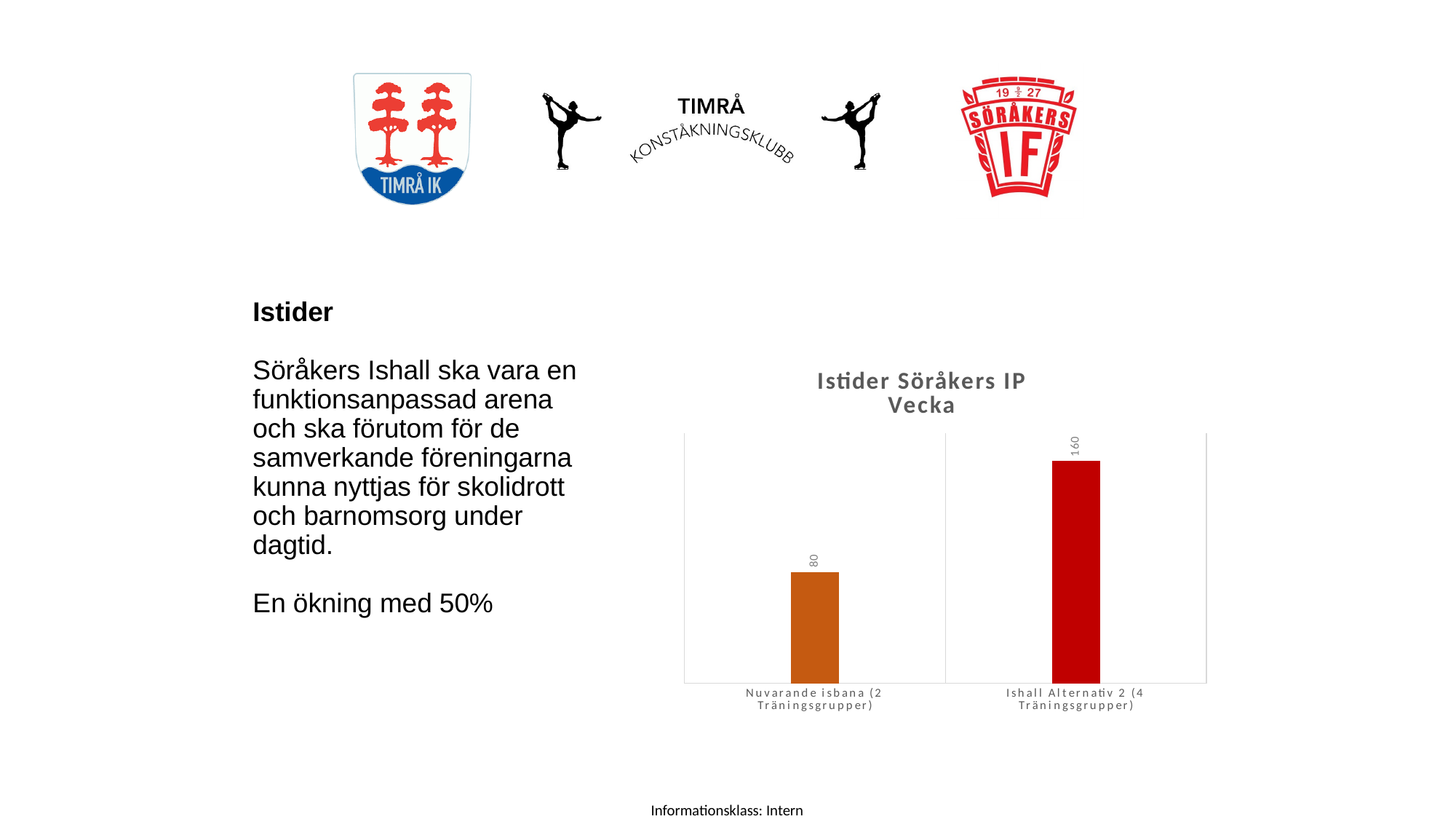
What is the title of the chart? Istider Söråkers IP Vecka Which category has the highest value? Ishall Alternativ 2 (4 Träningsgrupper) Which category has the lowest value? Nuvarande isbana (2 Träningsgrupper) What colour is the bar for Ishall Alternativ 2 (4 Träningsgrupper)? Red What is the value for Nuvarande isbana (2 Träningsgrupper)? 80 How many categories are shown in the chart? 2 What is the difference between the values for Ishall Alternativ 2 (4 Träningsgrupper) and Nuvarande isbana (2 Träningsgrupper)? 80 What is the value for Ishall Alternativ 2 (4 Träningsgrupper)? 160 Do the values rise or fall from left to right along the x axis? Rise What kind of chart is shown on the slide? Bar chart Which is larger, the value for Nuvarande isbana (2 Träningsgrupper) or the value for Ishall Alternativ 2 (4 Träningsgrupper)? Ishall Alternativ 2 (4 Träningsgrupper)